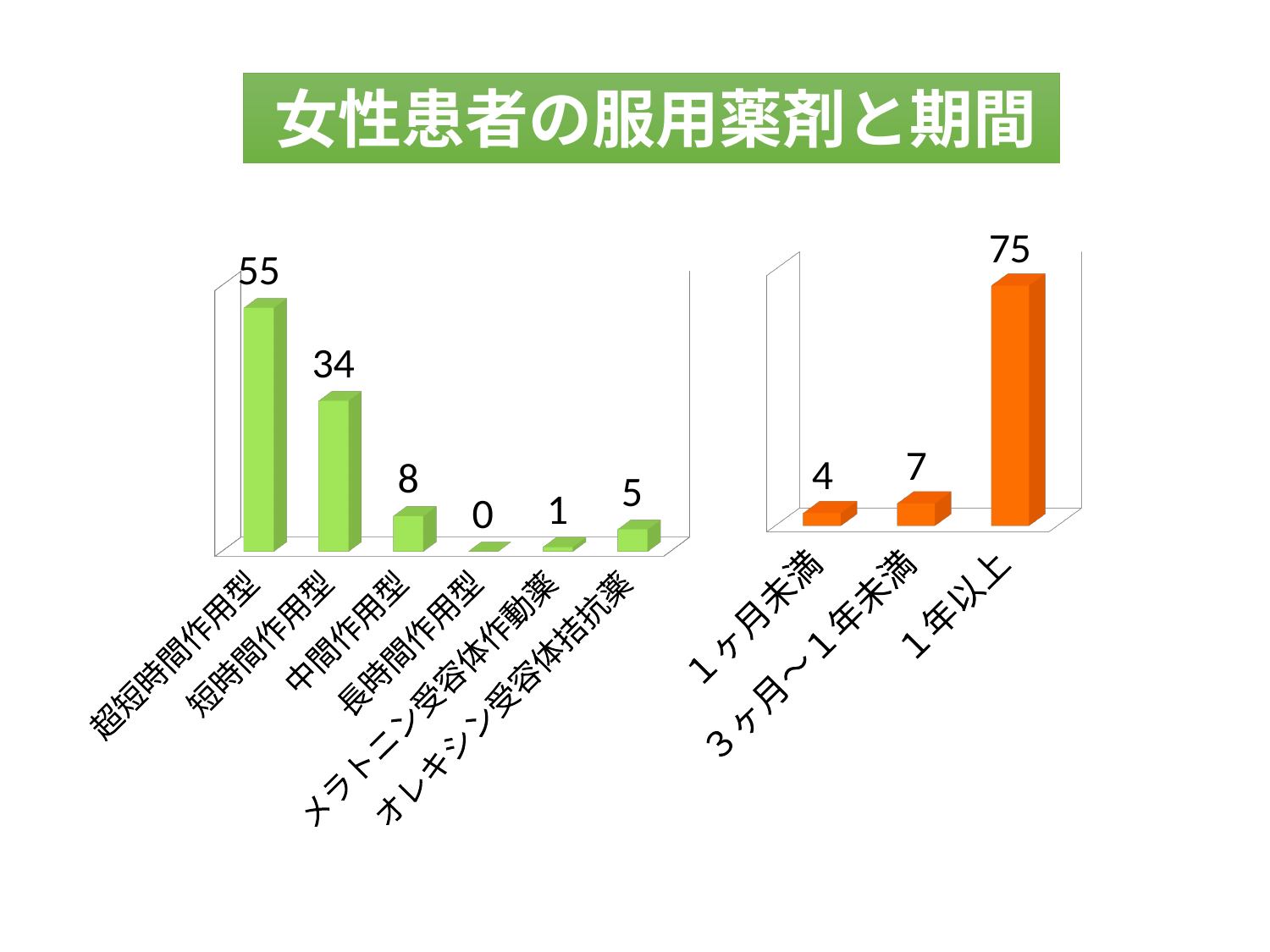
In the left chart, what is the value for メラトニン受容体作動薬? 1 In the left chart, what is the difference between 超短時間作用型 and 短時間作用型? 21 In the left chart, what is the value for 超短時間作用型? 55 In the left chart, what is the value for 中間作用型? 8 In the right chart, which is larger, 1ヶ月未満 or 3ヶ月～1年未満? 3ヶ月～1年未満 What kind of chart is the right chart? Bar chart In the right chart, what is the value for 1年以上? 75 In the left chart, how many categories are shown? 6 In the left chart, which category has the highest value? 超短時間作用型 In the right chart, what is the difference between 1年以上 and 1ヶ月未満? 71 In the left chart, which category has the lowest value? 長時間作用型 In the right chart, what is the value for 3ヶ月～1年未満? 7